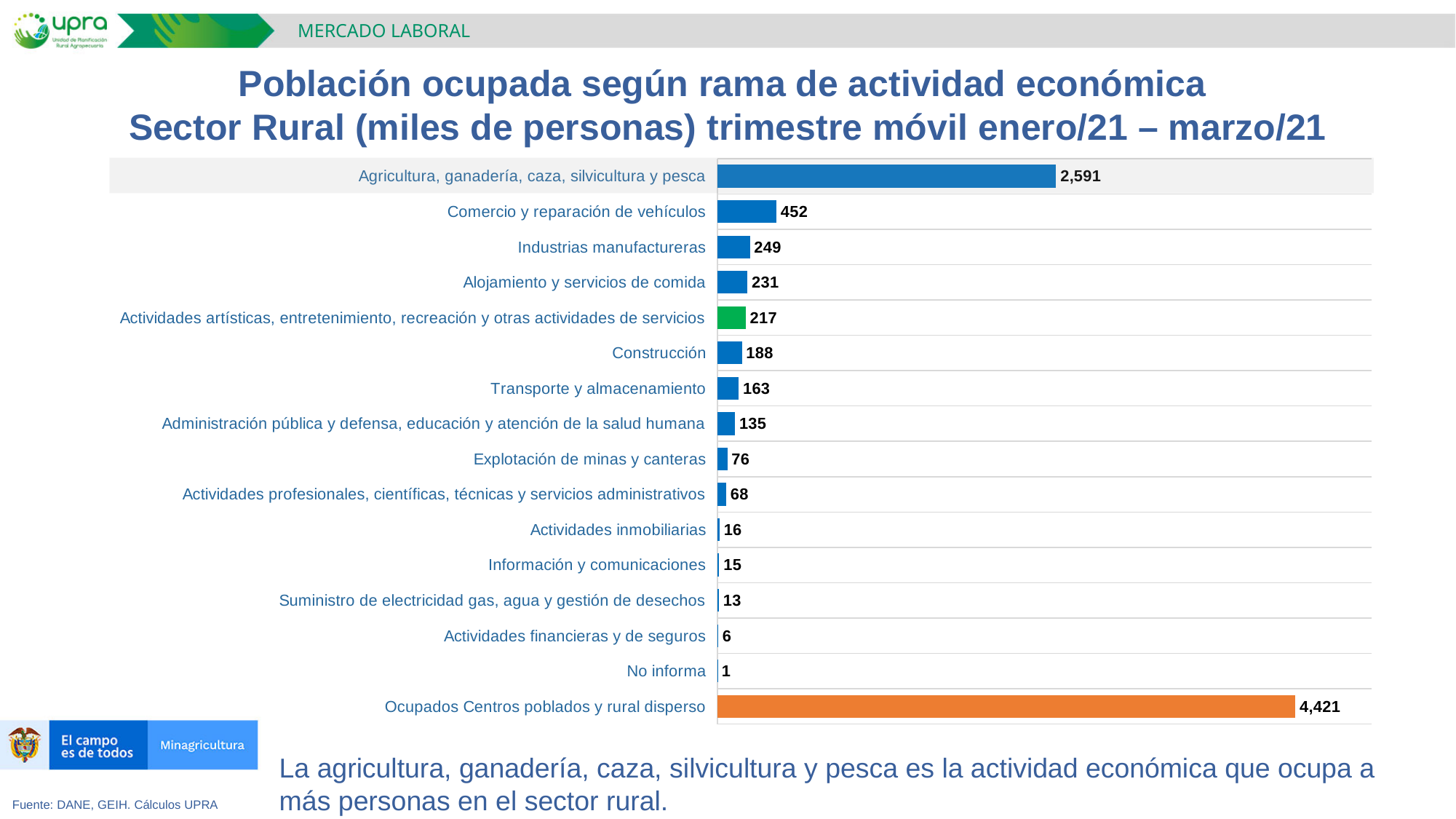
Which is larger, the value for Construcción or the value for Transporte y almacenamiento? Construcción Which economic activity (excluding the total bar Ocupados Centros poblados y rural disperso) has the highest value? Agricultura, ganadería, caza, silvicultura y pesca What is the value for Explotación de minas y canteras? 76 What is the value for Comercio y reparación de vehículos? 452 What is the value for Ocupados Centros poblados y rural disperso? 4,421 How many categories (bars) are shown in the chart? 16 What is the difference between the values for Industrias manufactureras and Alojamiento y servicios de comida? 18 What is the value for Agricultura, ganadería, caza, silvicultura y pesca? 2,591 Which category has the lowest value? No informa What colour is the bar for Actividades artísticas, entretenimiento, recreación y otras actividades de servicios? Green What kind of chart is shown on the slide? Bar chart What is the difference between the values for Agricultura, ganadería, caza, silvicultura y pesca and Comercio y reparación de vehículos? 2,139